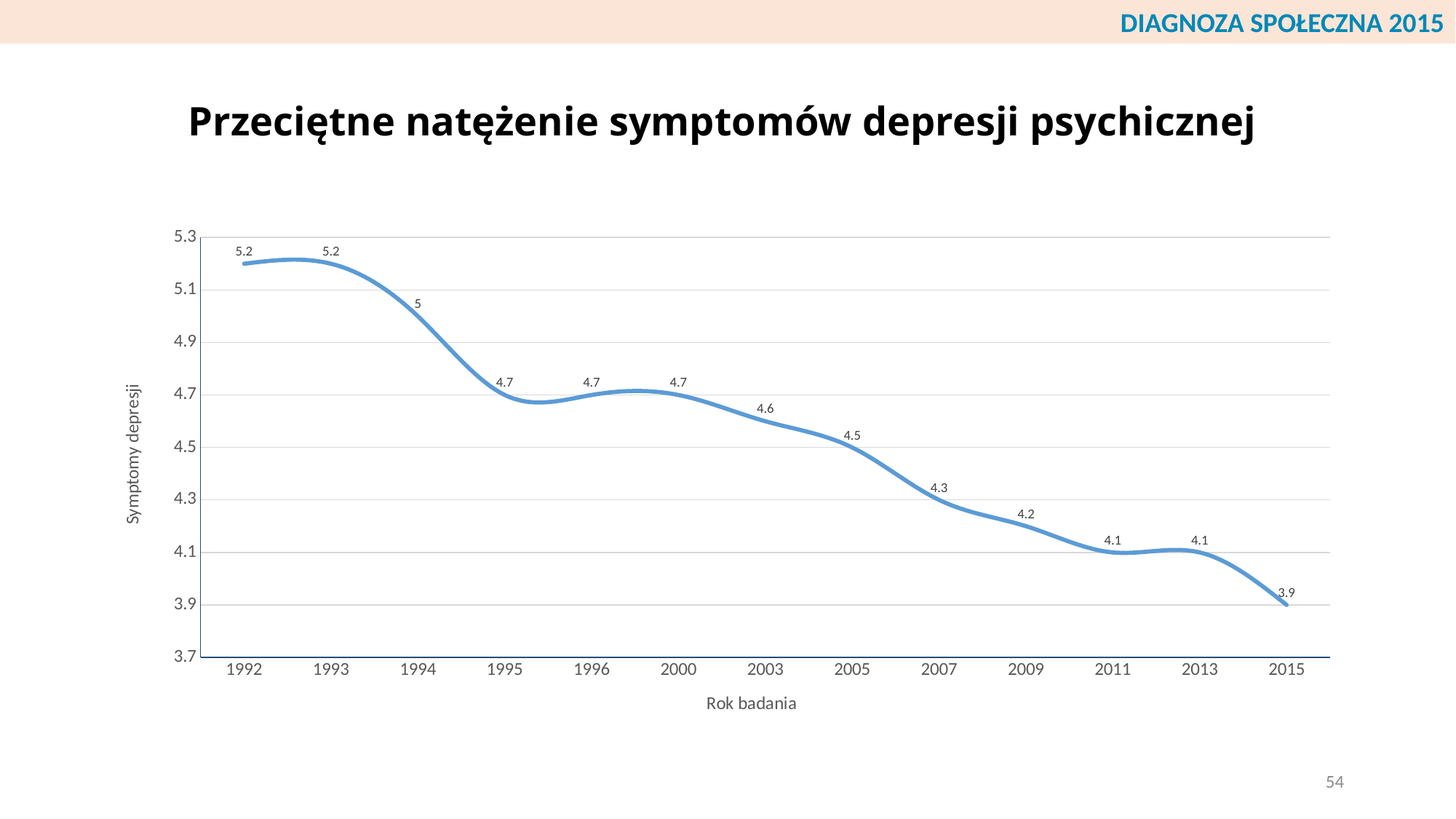
What is the value for 1992? 5.2 Which year has the lowest value? 2015 Is the value for 2007 greater or less than 4.5? less What is the value for 2005? 4.5 What is the value for 1994? 5 What is the value for 2015? 3.9 What is the label of the x axis? Rok badania What kind of chart is shown? line chart Which is larger, the value for 2003 or the value for 2009? 2003 What is the difference between the values for 1992 and 2015? 1.3 Do the values rise or fall from 1992 to 2015? fall How many years are plotted on the x axis? 13